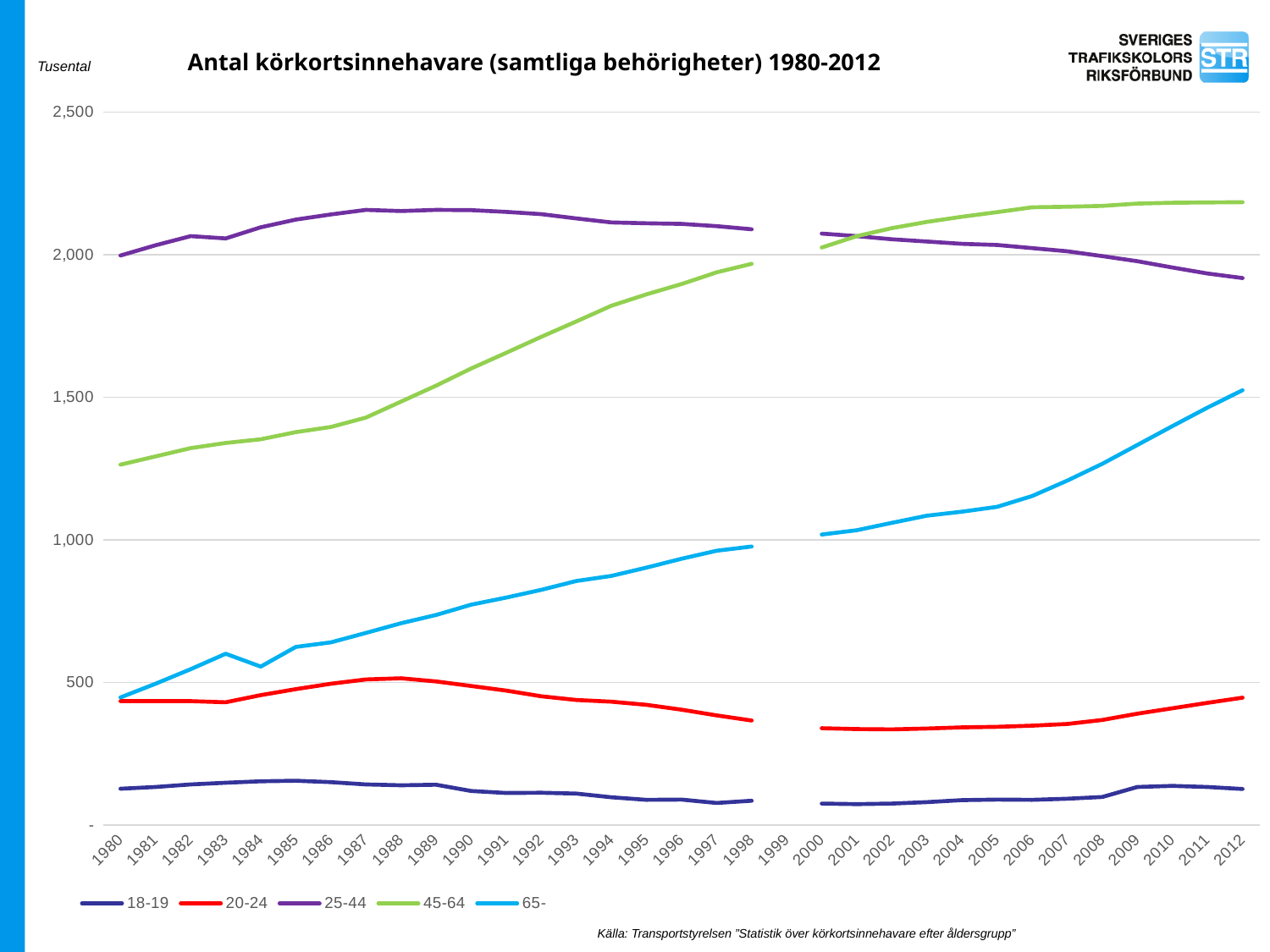
Which age group has the highest value in 1990? 25-44 In 1980, which is larger: the value for 25-44 or the value for 45-64? 25-44 Which age group has the highest value in 2012? 45-64 What kind of chart is shown on the slide? line chart Does the 25-44 series rise or fall between 2000 and 2012? fall Is the value for the 65- group in 2012 greater or less than 1,000? greater Which age group has the lowest value in 2012? 18-19 How many years are labelled along the x axis? 33 How many series does the legend list? 5 Is the value for the 65- group in 1980 greater or less than 500? less In 2012, which is larger: the value for 20-24 or the value for 65-? 65- Is the value for the 45-64 group in 1980 greater or less than 1,000? greater